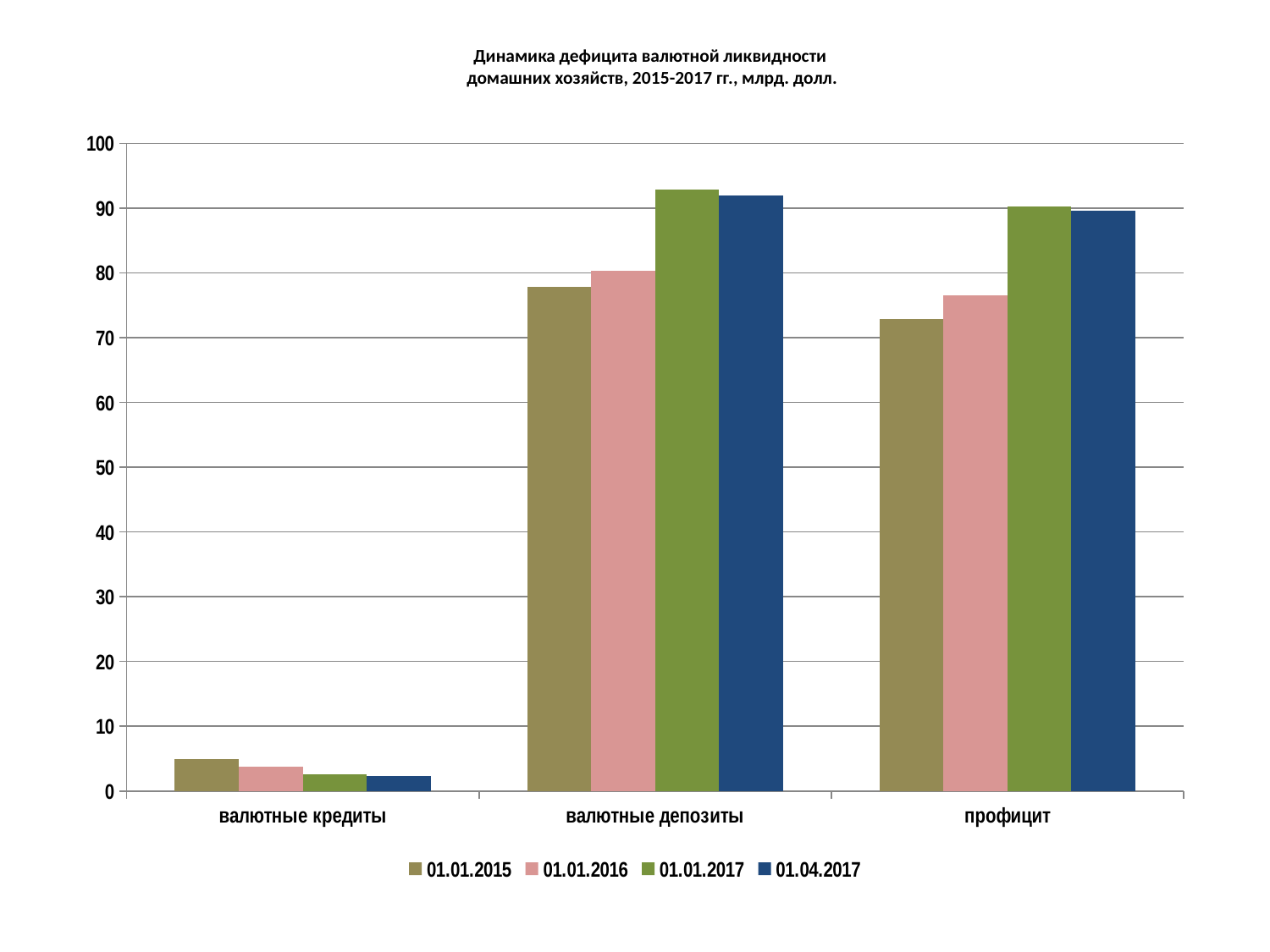
Is the value for валютные кредиты on 01.01.2015 greater or less than 10? less Is the value for валютные депозиты on 01.01.2015 greater or less than 80? less For валютные депозиты, which is larger: the value on 01.01.2015 or on 01.01.2017? 01.01.2017 How many series does the legend list? 4 Do the values for валютные кредиты rise or fall from 01.01.2015 to 01.04.2017? fall Which category has the highest value for the 01.01.2017 series? валютные депозиты Is the value for валютные депозиты on 01.01.2017 greater or less than 90? greater What kind of chart is shown on the slide? bar chart How many categories are shown on the x axis? 3 Which category has the lowest values across all series? валютные кредиты Which series is shown in dark blue in the legend? 01.04.2017